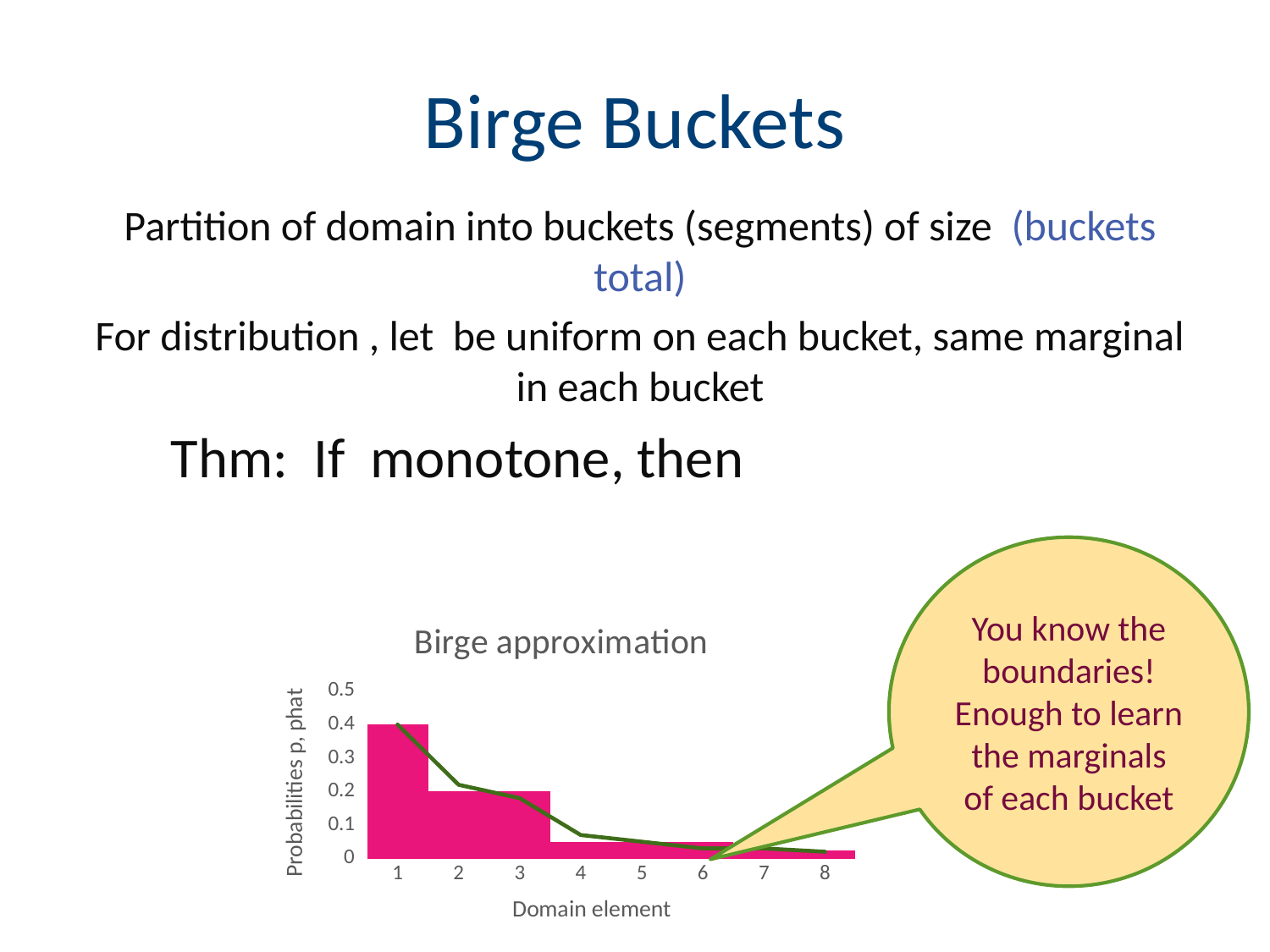
Which domain element has the highest bar in the chart? 1 How many domain elements are shown along the x axis of the chart? 8 Is the bar value for domain element 2 greater or less than 0.3? less Which has the larger bar value, domain element 1 or domain element 4? 1 Which has the larger bar value, domain element 2 or domain element 7? 2 What kind of chart is shown on the slide? combination bar and line chart What is the label of the x axis of the chart? Domain element Do the bar values rise or fall as the domain element increases from 1 to 8? fall Is the bar value for domain element 5 greater or less than 0.1? less Is the bar value for domain element 1 greater or less than 0.3? greater What is the title of the chart? Birge approximation